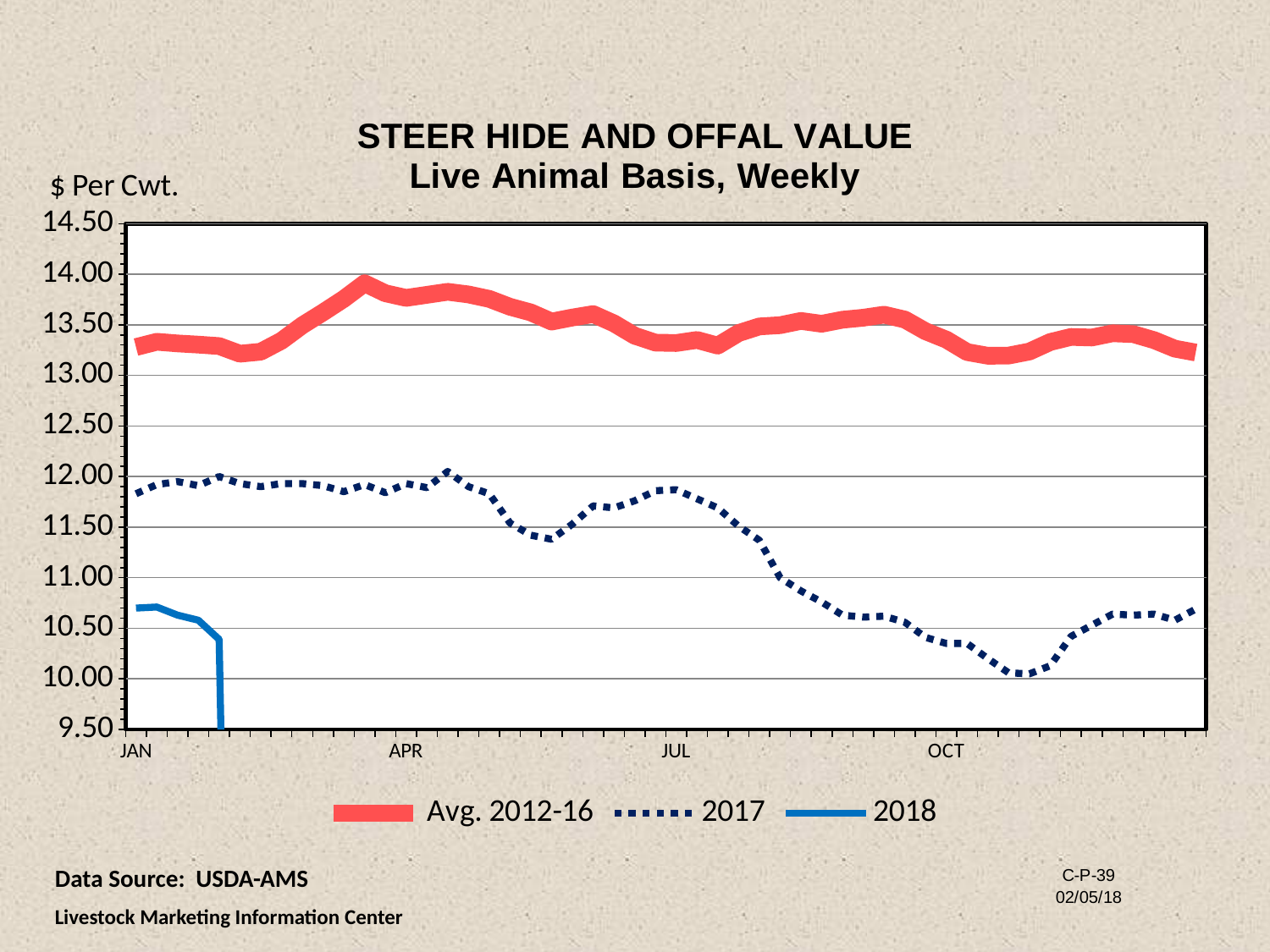
Which series is higher in JAN, Avg. 2012-16 or 2017? Avg. 2012-16 Is the 2017 value at OCT greater or less than 11.00? less What are the three series listed in the legend? Avg. 2012-16, 2017, 2018 Is the Avg. 2012-16 value at APR greater or less than 13.50? greater Is the 2017 value in JAN greater or less than 12.00? less How many series does the legend list? 3 What is the label on the vertical axis of the chart? $ Per Cwt. What kind of chart is shown on the slide? line chart Does the 2017 line rise or fall between JUL and OCT? fall Which series is higher in JAN, 2017 or 2018? 2017